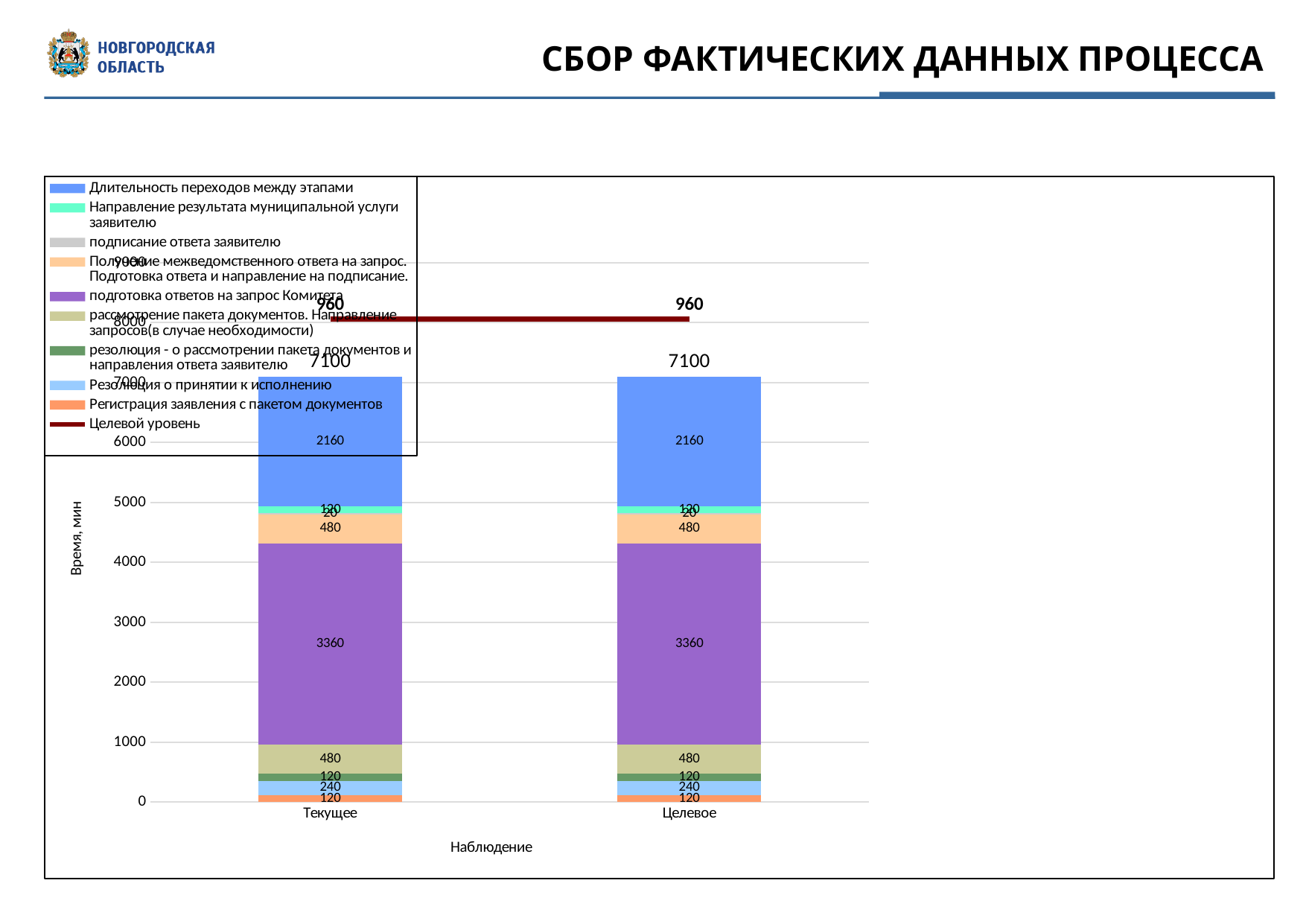
What is the value of the подготовка ответов на запрос Комитета segment in the Текущее bar? 3360 How many categories are shown on the x axis? 2 What value is shown for the Целевой уровень line? 960 What is the value of the Регистрация заявления с пакетом документов segment in the Текущее bar? 120 Which segment is the largest in the Текущее bar? подготовка ответов на запрос Комитета How many entries does the legend list? 10 What is the difference between the подготовка ответов на запрос Комитета segment (3360) and the Длительность переходов между этапами segment (2160) in the Целевое bar? 1200 What type of chart is shown on the slide? stacked bar chart with a target level line (combination bar and line chart) What is the value of the Длительность переходов между этапами segment in the Целевое bar? 2160 What is the total of the stacked bar for Текущее? 7100 Is the total of the Текущее bar greater or less than 7000? greater What is the total of the stacked bar for Целевое? 7100